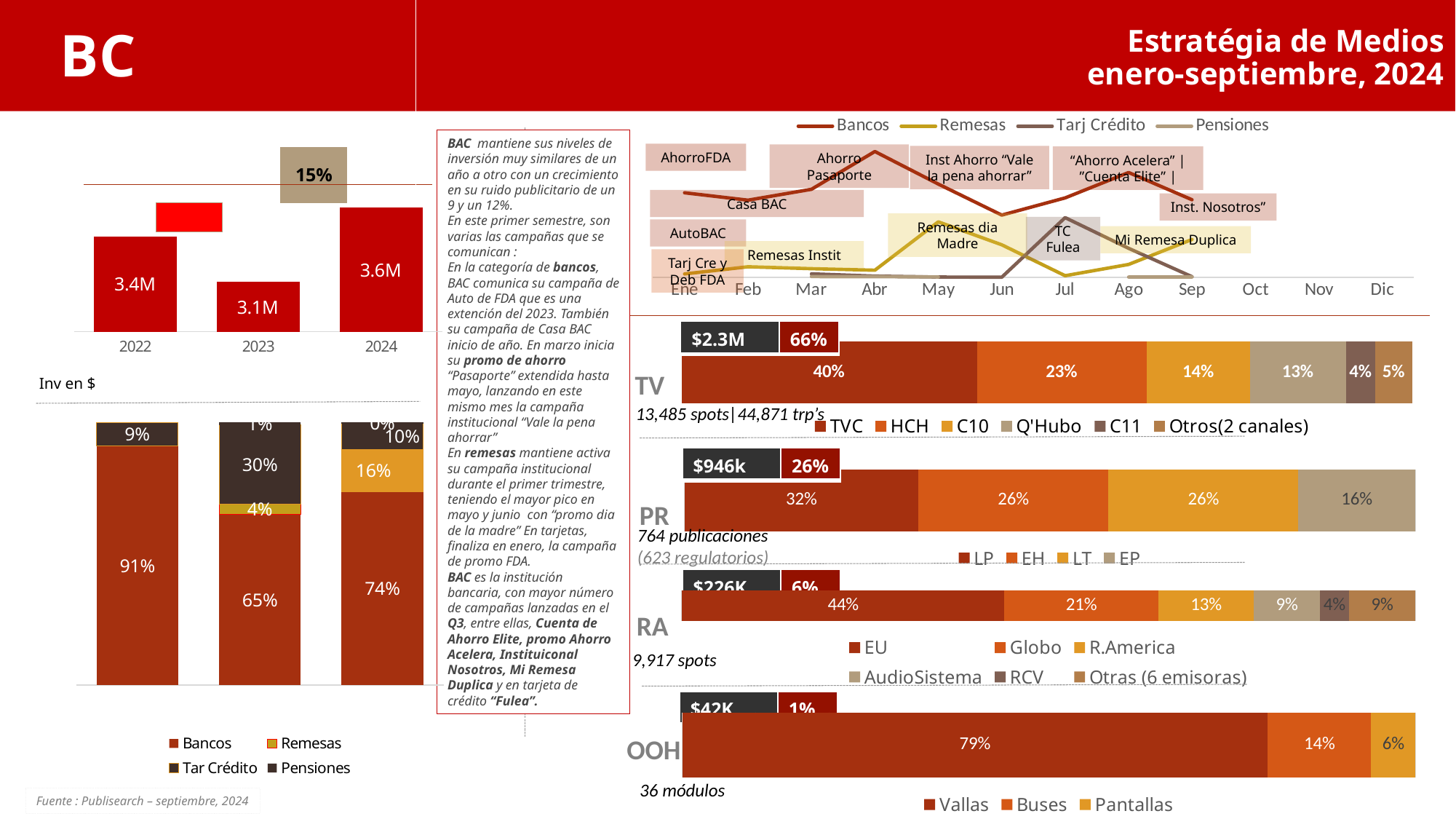
In the 'Inv en $' bar chart on the left, what is the value for 2024? 3.6M In the stacked bar chart at the bottom left, how many series does the legend list? 4 In the 'Inv en $' bar chart on the left, what kind of chart is it? bar chart In the 'Inv en $' bar chart on the left, which year has the lowest investment? 2023 In the TV stacked bar on the right, what share does HCH have? 23% In the OOH stacked bar on the right, what share does Vallas have? 79% In the line chart at the top right, how many months are shown on the x axis? 12 In the PR stacked bar on the right, which channel has the largest share? LP In the stacked bar chart at the bottom left, what share does Bancos have in 2023? 65% In the stacked bar chart at the bottom left, what share does Remesas have in 2024? 16% In the RA stacked bar on the right, which is larger, the share for Globo or the share for R.America? Globo In the TV stacked bar on the right, what is the difference between the TVC share and the C10 share? 26%